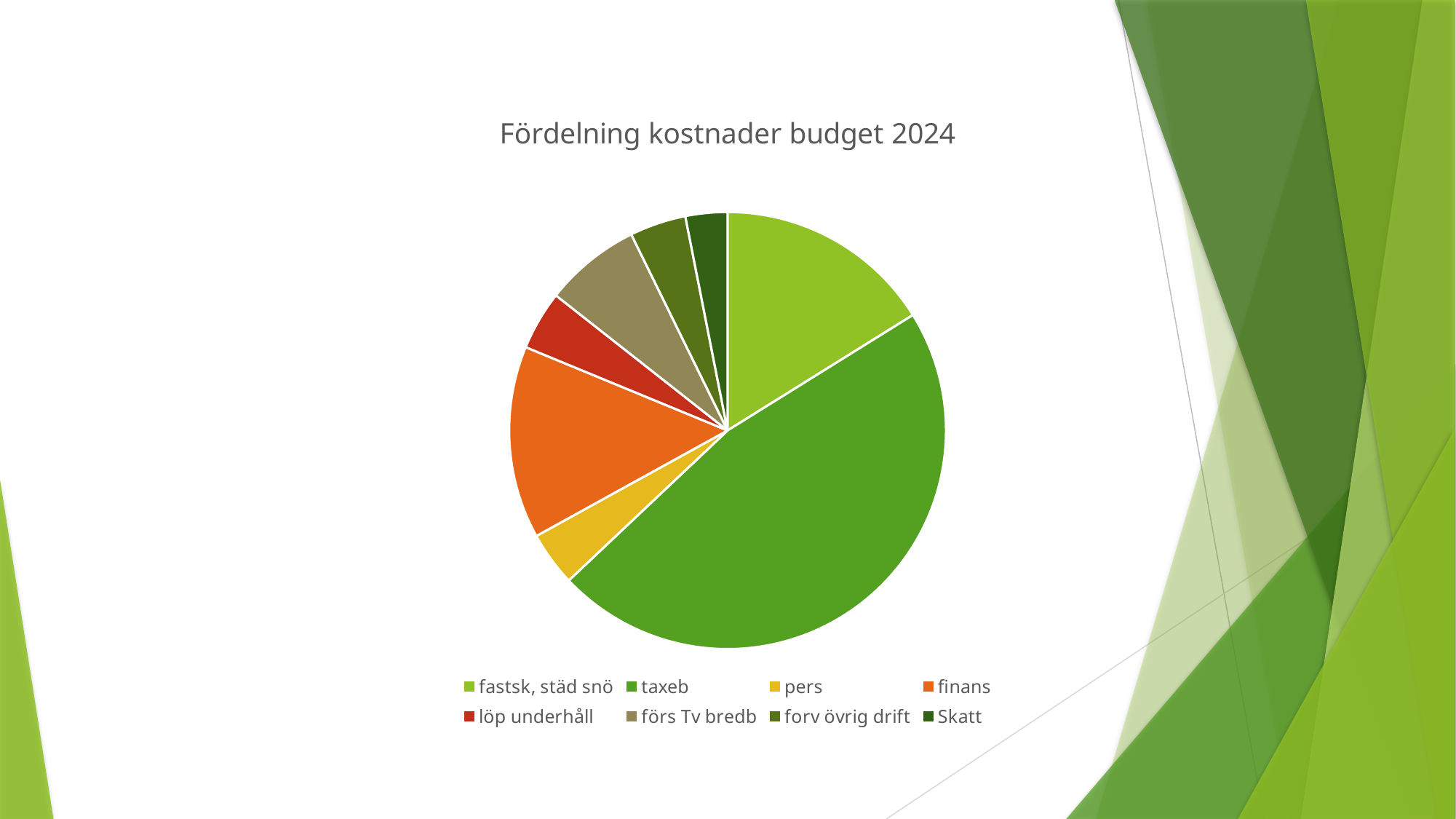
Which slice is larger, taxeb or finans? taxeb What colour is the finans slice in the pie chart? orange Which category has the largest slice of the pie? taxeb Which slice is larger, fastsk, städ snö or pers? fastsk, städ snö Which category is the second largest slice of the pie? fastsk, städ snö How many entries does the legend list? 8 Which slice is larger, förs Tv bredb or Skatt? förs Tv bredb What kind of chart is shown on the slide? pie chart How many categories (slices) does the pie chart have? 8 What is the title of the chart? Fördelning kostnader budget 2024 Which category has the smallest slice of the pie? Skatt